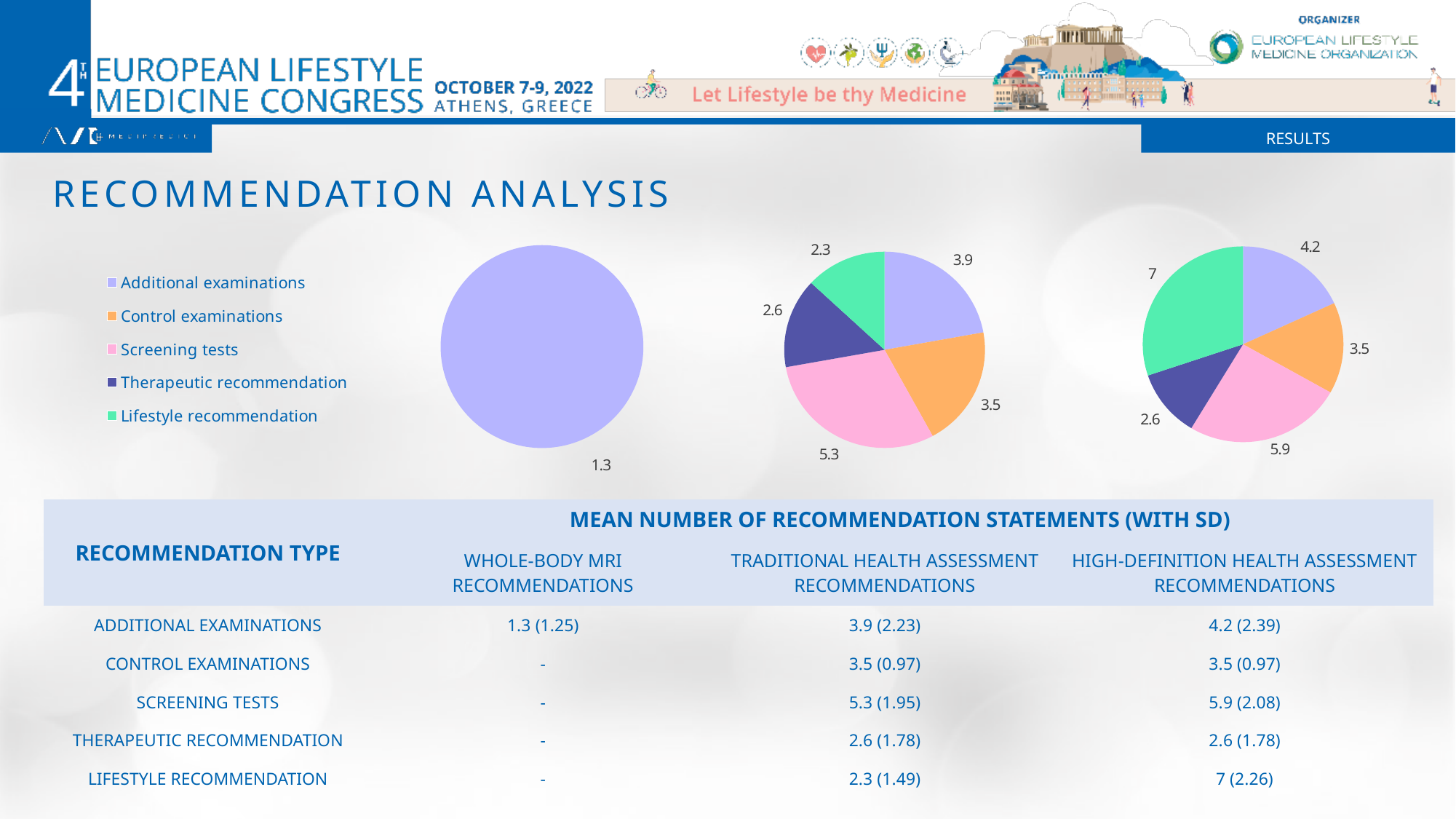
In the middle pie chart, which category has the smallest slice? Lifestyle recommendation In the middle pie chart, what is the value for Screening tests? 5.3 In the right pie chart, what is the value for Lifestyle recommendation? 7 What kind of chart is the middle chart on the slide? Pie chart How many pie charts are shown on the slide? 3 How many categories does the legend list? 5 In the middle pie chart, which category has the largest slice? Screening tests In the right pie chart, which category has the largest slice? Lifestyle recommendation How many slices does the right pie chart have? 5 In the middle pie chart, which is larger: Additional examinations or Control examinations? Additional examinations In the right pie chart, what is the difference between the Screening tests value and the Control examinations value? 2.4 In the left pie chart, what value is labelled on the single slice? 1.3